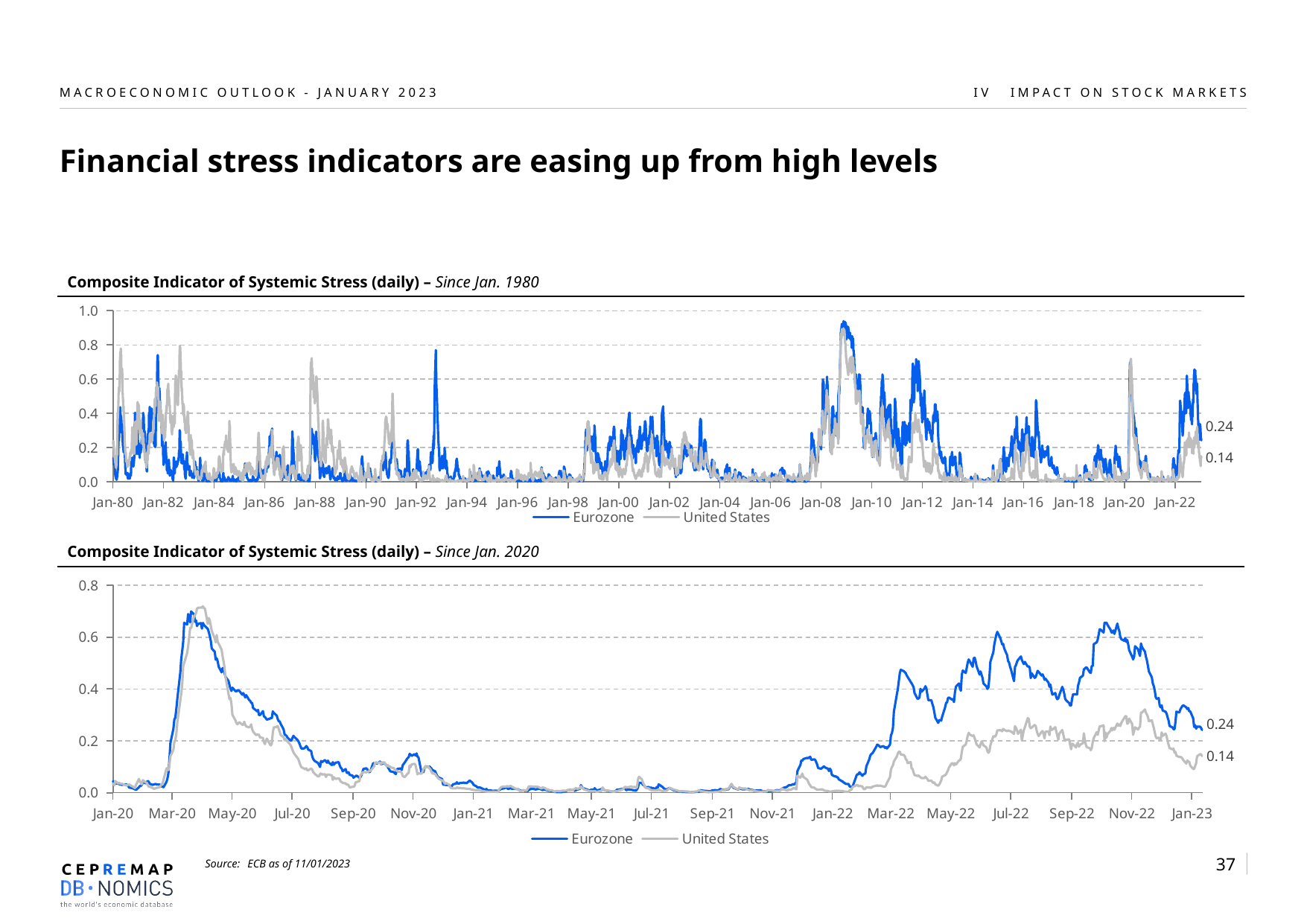
In the 'Since Jan. 2020' chart, is the Eurozone peak around Mar-20 greater or less than 0.6? greater In the 'Since Jan. 1980' chart, is the Eurozone peak around Jan-09 greater or less than 0.8? greater In the legend of the 'Since Jan. 1980' chart, which colour represents the Eurozone? blue What kind of chart is the 'Composite Indicator of Systemic Stress (daily) – Since Jan. 1980' chart? line chart How many series does the legend of the 'Since Jan. 2020' chart list? 2 In the 'Since Jan. 2020' chart, is the highest United States value during 2022 greater or less than 0.4? less In the 'Since Jan. 2020' chart, does the Eurozone line rise or fall between Nov-22 and Jan-23? fall In the 'Since Jan. 2020' chart, which series reaches the higher level during 2022, Eurozone or United States? Eurozone In the 'Since Jan. 2020' chart, what is the latest labelled value for the United States? 0.14 In the 'Since Jan. 1980' chart, what is the difference between the latest labelled Eurozone value and the latest labelled United States value? 0.10 In the 'Since Jan. 2020' chart, what is the latest labelled value for the Eurozone? 0.24 In the 'Since Jan. 2020' chart, which series has the higher latest labelled value, Eurozone or United States? Eurozone